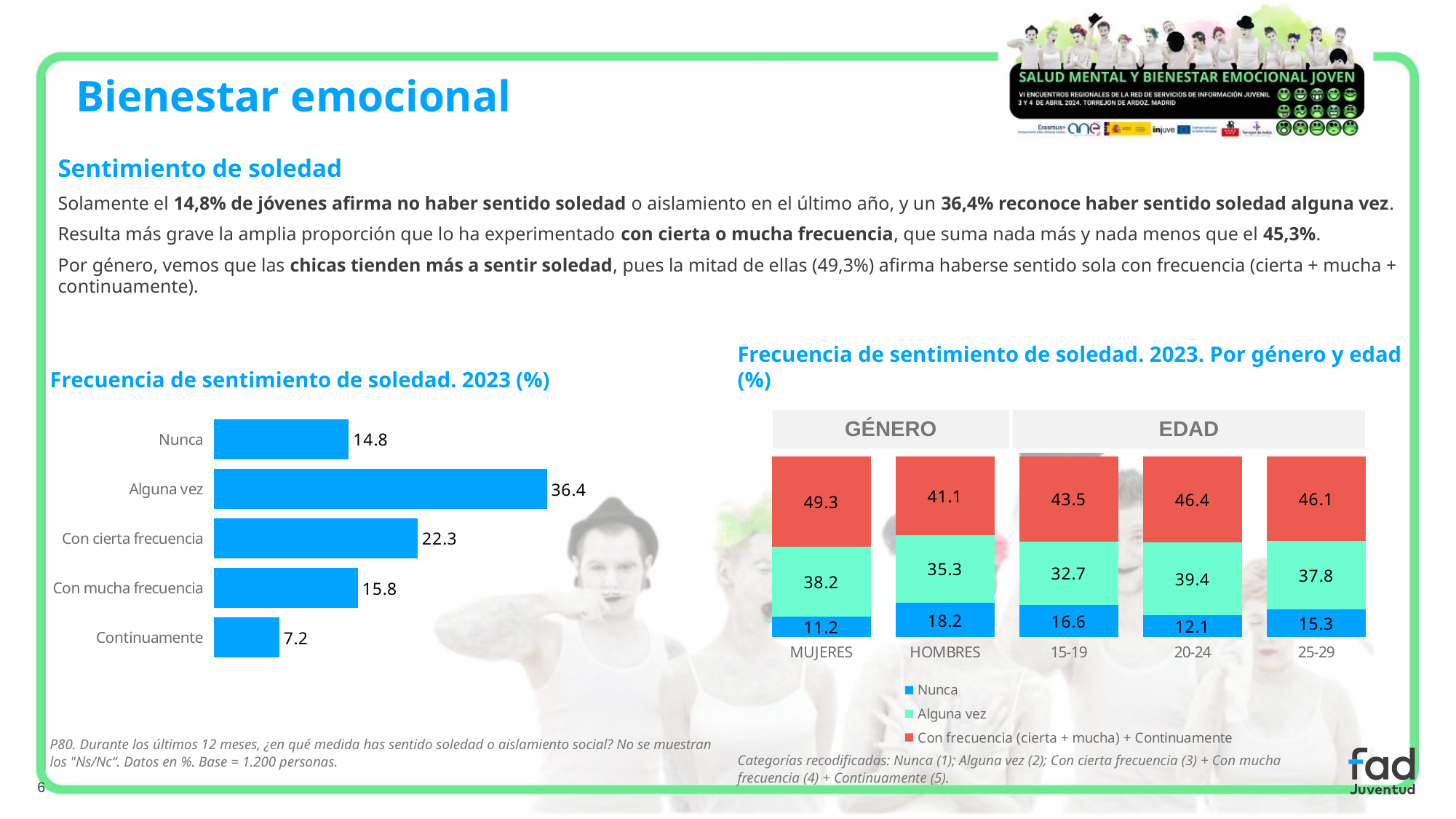
In the chart 'Frecuencia de sentimiento de soledad. 2023 (%)', what is the difference between 'Con cierta frecuencia' and 'Con mucha frecuencia'? 6.5 In the chart 'Frecuencia de sentimiento de soledad. 2023. Por género y edad (%)', what is the 'Nunca' value for HOMBRES? 18.2 What kind of chart is 'Frecuencia de sentimiento de soledad. 2023 (%)'? Bar chart In the chart 'Frecuencia de sentimiento de soledad. 2023 (%)', how many categories are shown? 5 In the chart 'Frecuencia de sentimiento de soledad. 2023. Por género y edad (%)', what is the total of the stacked bar for the 15-19 group? 92.8 In the chart 'Frecuencia de sentimiento de soledad. 2023. Por género y edad (%)', which category has the highest 'Con frecuencia (cierta + mucha) + Continuamente' value? MUJERES In the chart 'Frecuencia de sentimiento de soledad. 2023. Por género y edad (%)', how many series does the legend list? 3 In the chart 'Frecuencia de sentimiento de soledad. 2023. Por género y edad (%)', what is the 'Alguna vez' value for the 20-24 group? 39.4 In the chart 'Frecuencia de sentimiento de soledad. 2023 (%)', which category has the highest value? Alguna vez In the chart 'Frecuencia de sentimiento de soledad. 2023 (%)', what is the value for 'Alguna vez'? 36.4 In the chart 'Frecuencia de sentimiento de soledad. 2023 (%)', which category has the lowest value? Continuamente In the chart 'Frecuencia de sentimiento de soledad. 2023. Por género y edad (%)', is the 'Nunca' value larger for MUJERES or HOMBRES? HOMBRES